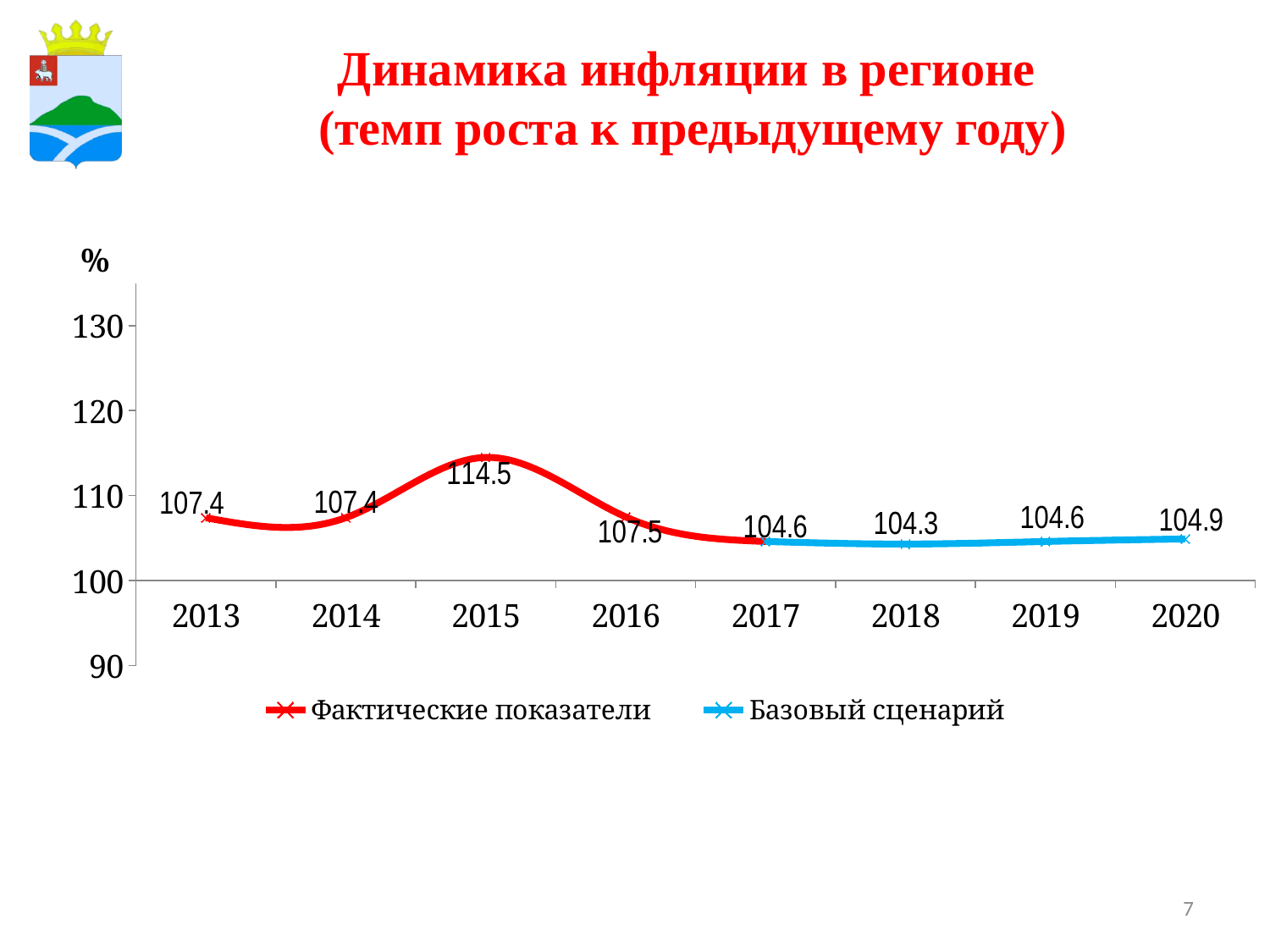
What is the value for 2020 in the Базовый сценарий series? 104.9 What type of chart is shown on the slide? line chart What colour is the line for Фактические показатели? red How many series does the legend list? 2 What is the inflation value for 2015? 114.5 What is the difference between the values for 2015 and 2016? 7 Which is larger, the value for 2016 or the value for 2017? 2016 How many years are shown on the x axis? 8 Which year has the highest value on the chart? 2015 Which year has the lowest value on the chart? 2018 What is the value for 2013? 107.4 What is the value for 2018? 104.3